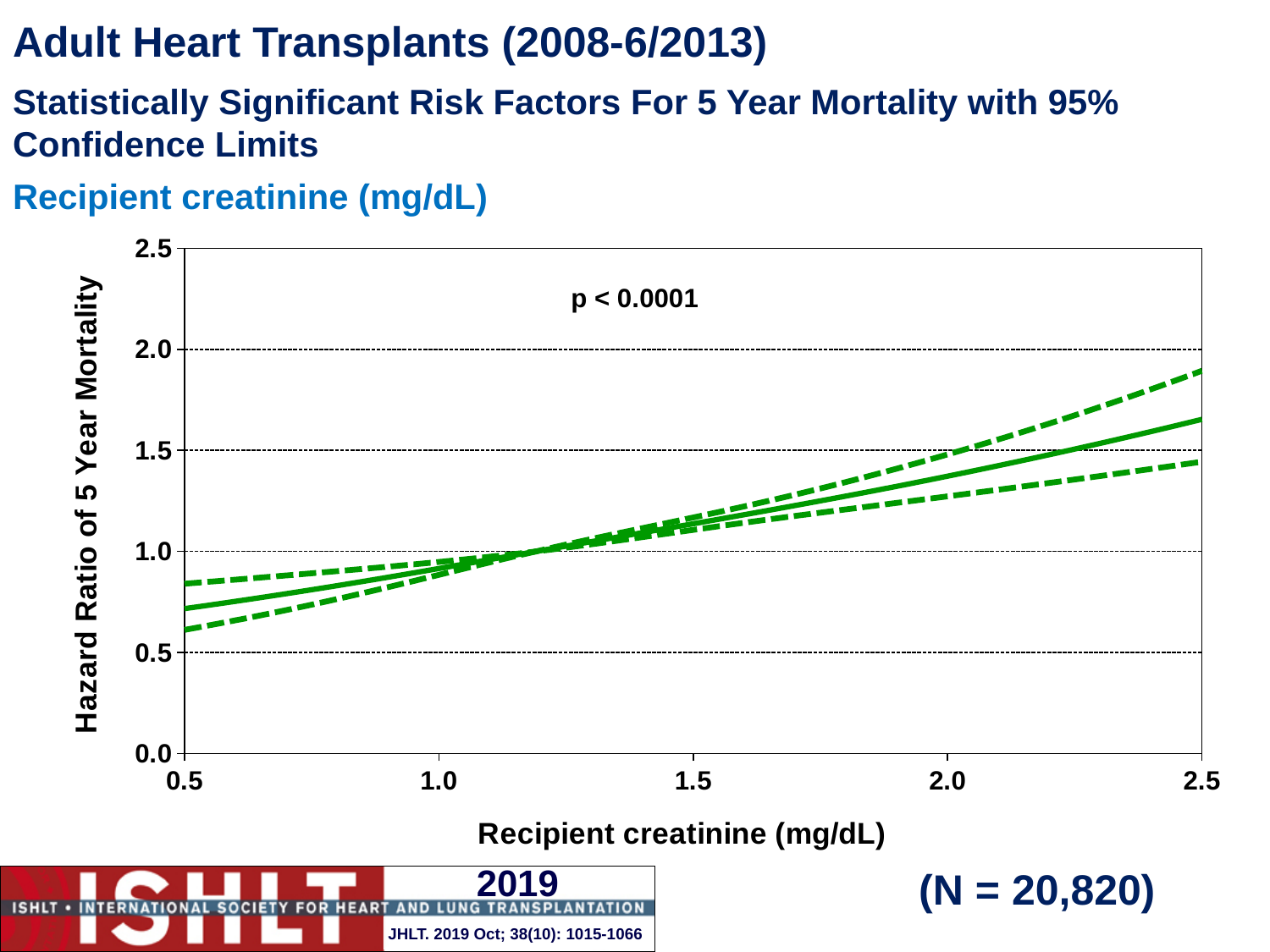
What kind of chart is shown on the slide? line chart How many lines are plotted on the chart (solid and dashed combined)? 3 Is the upper 95% confidence limit at a recipient creatinine of 2.5 mg/dL greater or less than 2.0? less What p-value is printed on the chart? p < 0.0001 Is the hazard ratio (solid line) at a recipient creatinine of 0.5 mg/dL greater or less than 1.0? less Is the lower 95% confidence limit at a recipient creatinine of 0.5 mg/dL greater or less than 0.5? greater Does the hazard ratio of 5 year mortality rise or fall as recipient creatinine increases from 0.5 to 2.5 mg/dL? rise What is the label of the y axis? Hazard Ratio of 5 Year Mortality Which is larger: the hazard ratio at a recipient creatinine of 2.5 mg/dL or at 1.0 mg/dL? 2.5 mg/dL